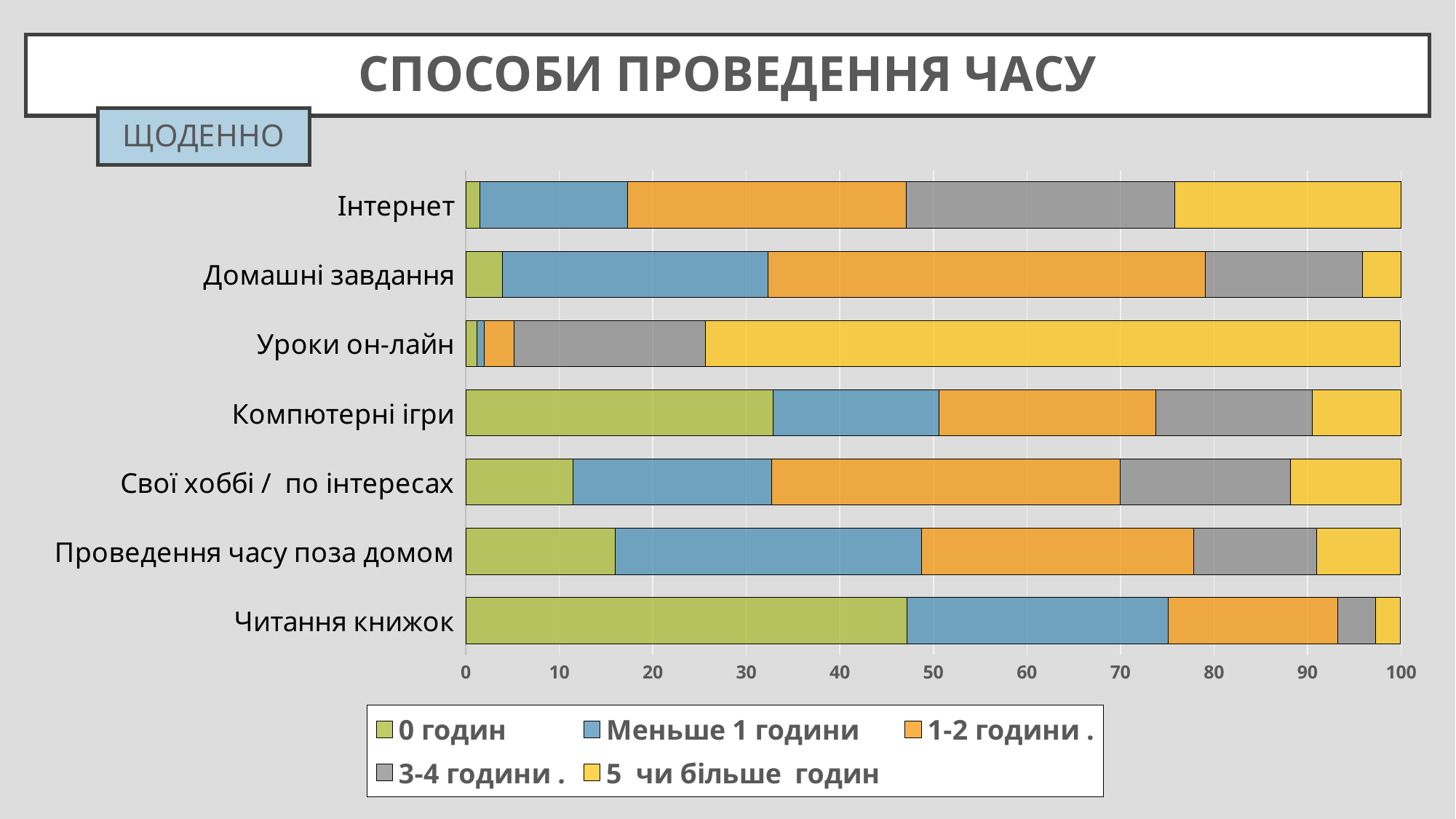
Which category has the largest "5 чи більше годин" segment? Уроки он-лайн Is the "5 чи більше годин" value for Уроки он-лайн greater or less than 60? greater Which category has the largest "0 годин" segment? Читання книжок Is the "0 годин" value for Читання книжок greater or less than 40? greater How many categories (activities) are plotted on the chart? 7 What is the title of the slide above the chart? СПОСОБИ ПРОВЕДЕННЯ ЧАСУ How many series does the legend list? 5 What kind of chart is shown on the slide? stacked bar chart Which has a larger "0 годин" segment: Компютерні ігри or Проведення часу поза домом? Компютерні ігри Which has a larger "3-4 години" segment: Інтернет or Читання книжок? Інтернет Which category has the largest "1-2 години" segment? Домашні завдання Which legend entry is shown in yellow? 5 чи більше годин